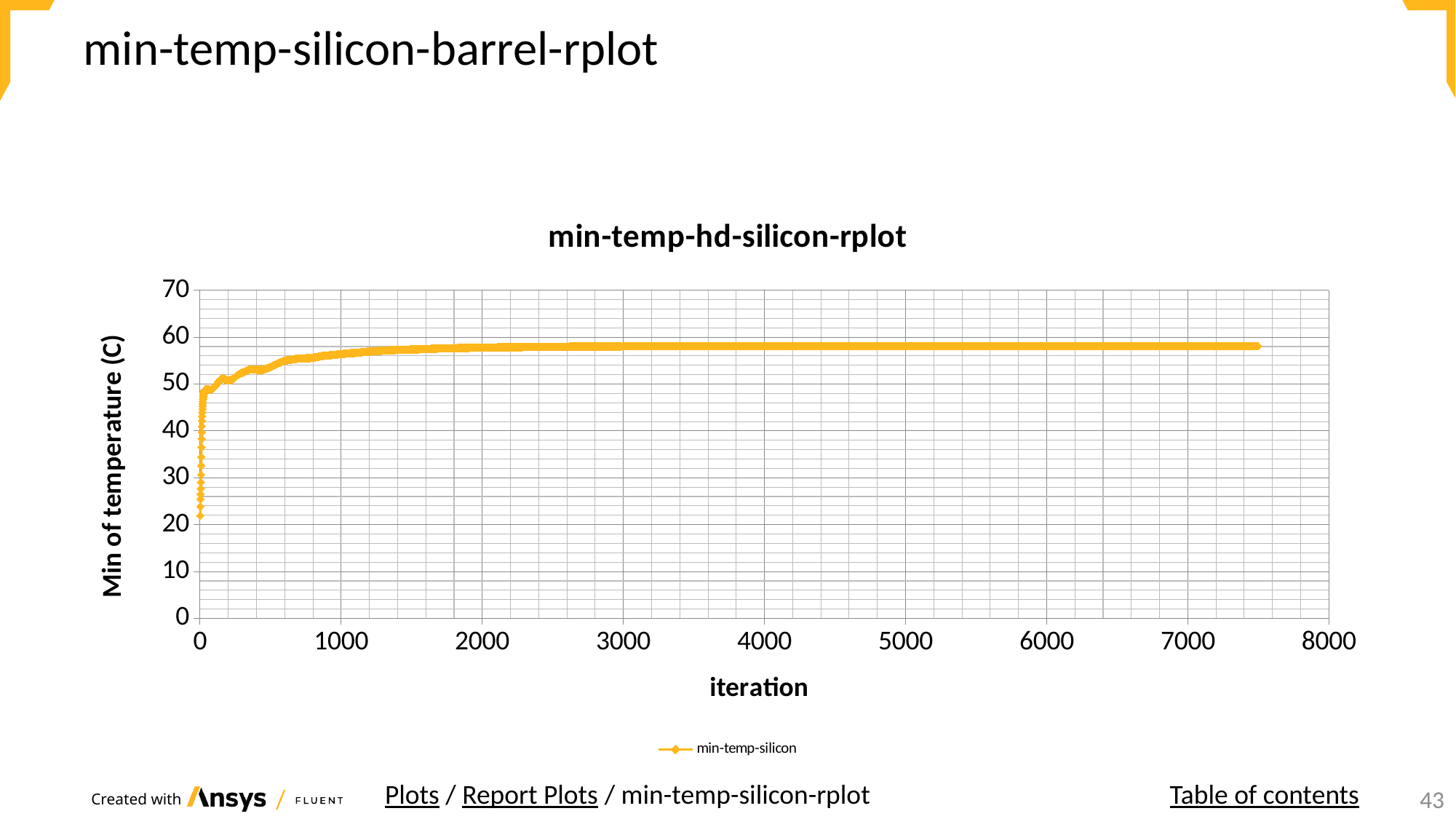
What kind of chart is shown on the slide? line chart What is the title of the chart? min-temp-hd-silicon-rplot What is the name of the series shown in the legend? min-temp-silicon How many series does the legend list? 1 Which is larger: the value of min-temp-silicon at iteration 100 or at iteration 5000? iteration 5000 Is the first plotted value of min-temp-silicon (at iteration 0) greater or less than 30? less Is the value of min-temp-silicon at iteration 7000 greater or less than 60? less Is the value of min-temp-silicon at iteration 4000 greater or less than 40? greater Do the values of min-temp-silicon rise or fall as the iteration increases? rise